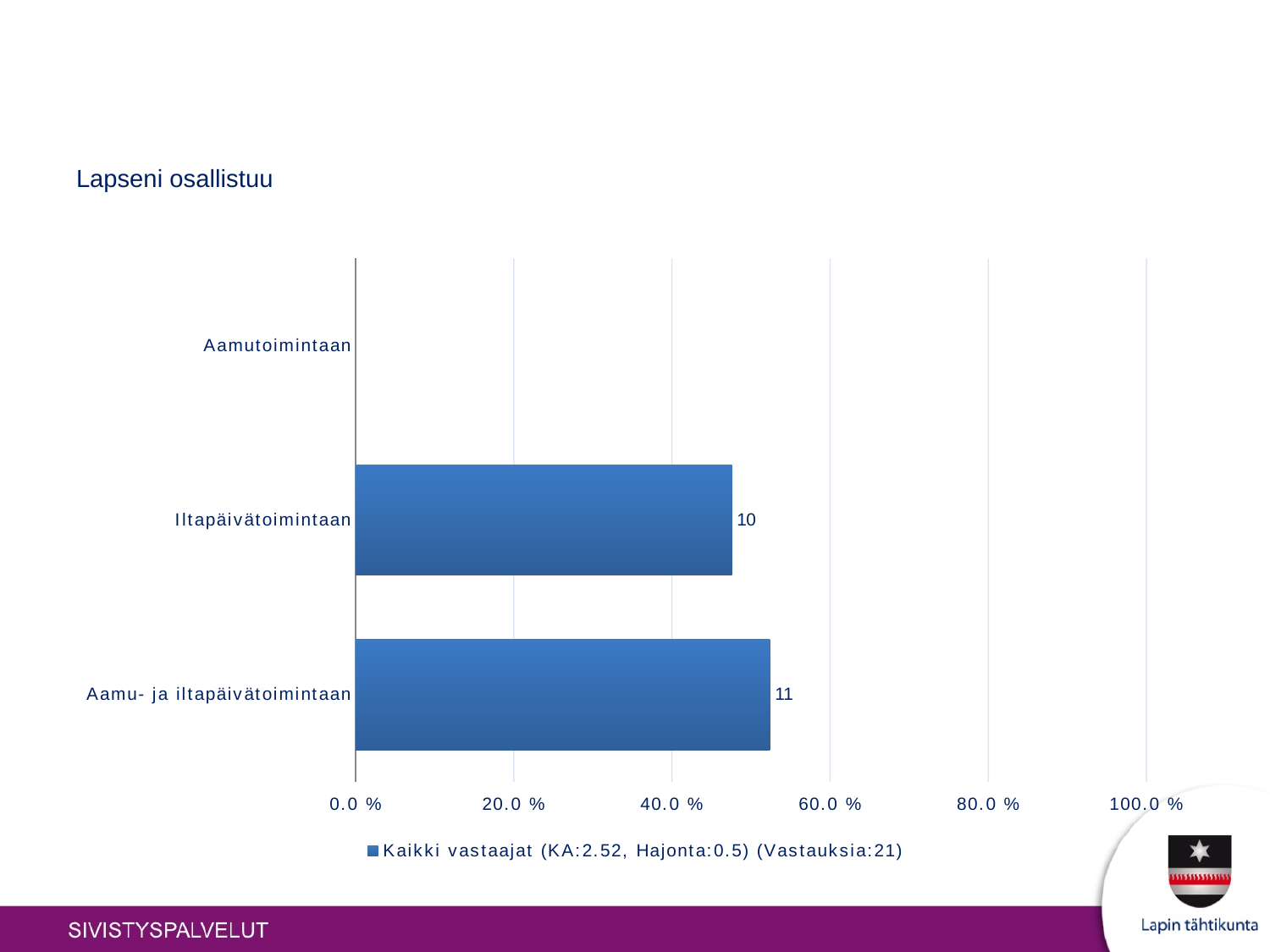
What is the data label shown for Aamu- ja iltapäivätoimintaan? 11 Is the bar for Iltapäivätoimintaan greater or less than 60.0 % on the axis? less Is the bar for Aamu- ja iltapäivätoimintaan greater or less than 40.0 % on the axis? greater What is the data label shown for Iltapäivätoimintaan? 10 What kind of chart is shown on the slide? Bar chart Which category has the longest bar? Aamu- ja iltapäivätoimintaan Which is larger, the value for Iltapäivätoimintaan or for Aamu- ja iltapäivätoimintaan? Aamu- ja iltapäivätoimintaan How many categories are shown on the vertical axis? 3 What is the difference between the data labels for Aamu- ja iltapäivätoimintaan and Iltapäivätoimintaan? 1 What is the title of the chart? Lapseni osallistuu How many series does the legend list? 1 Which category has the smallest value (no visible bar)? Aamutoimintaan